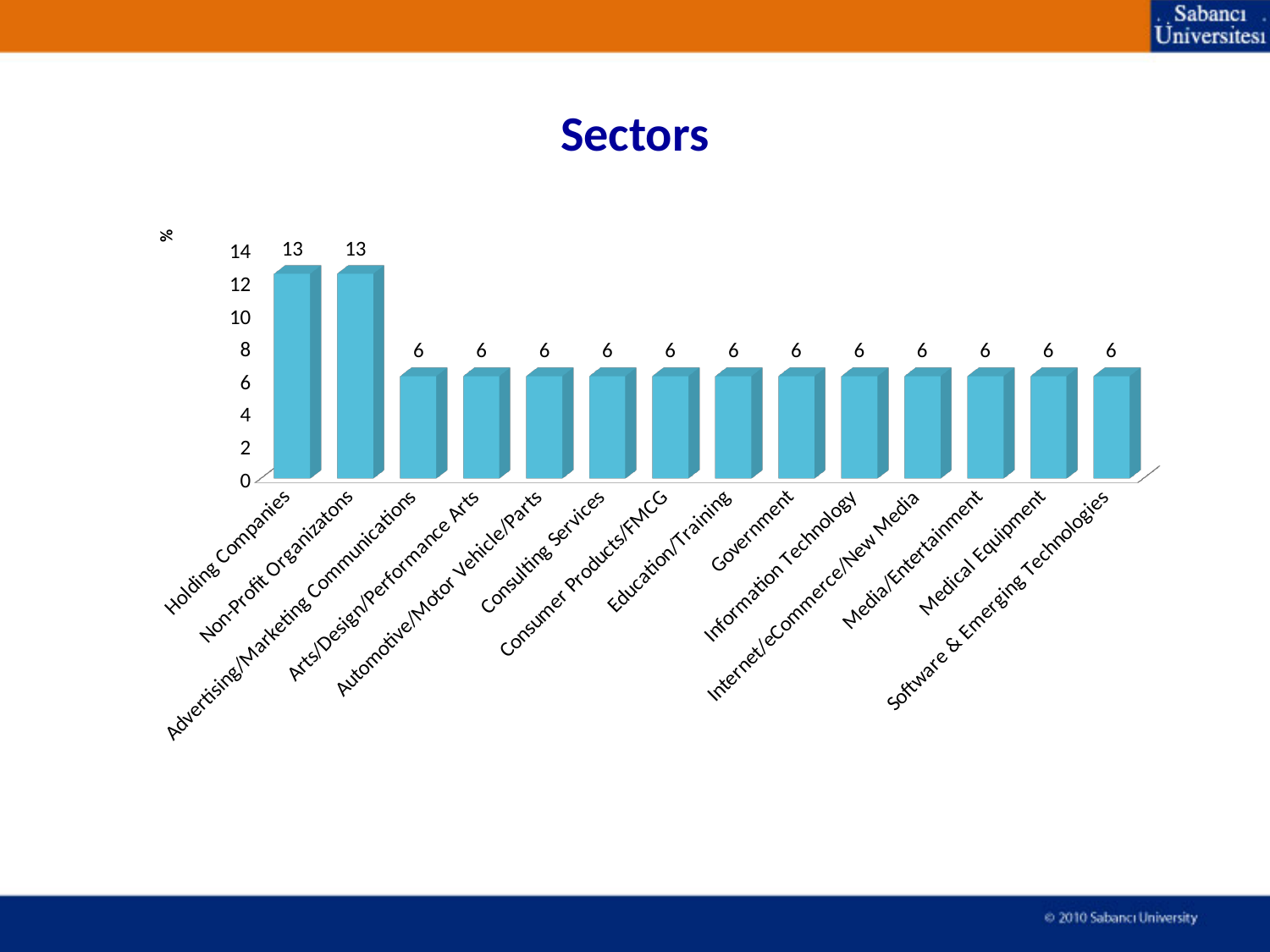
Which is larger, the value for Non-Profit Organizatons or the value for Medical Equipment? Non-Profit Organizatons How many categories are shown on the chart? 14 What is the value for Government? 6 What is the lowest value shown on the chart? 6 What is the title of the chart? Sectors What kind of chart is shown on the slide? bar chart What is the highest value shown on the chart? 13 Is the value for Information Technology greater or less than 10? less What is the difference between the values for Holding Companies and Consulting Services? 7 What is the value for Non-Profit Organizatons? 13 What is the value for Holding Companies? 13 What is the value for Software & Emerging Technologies? 6